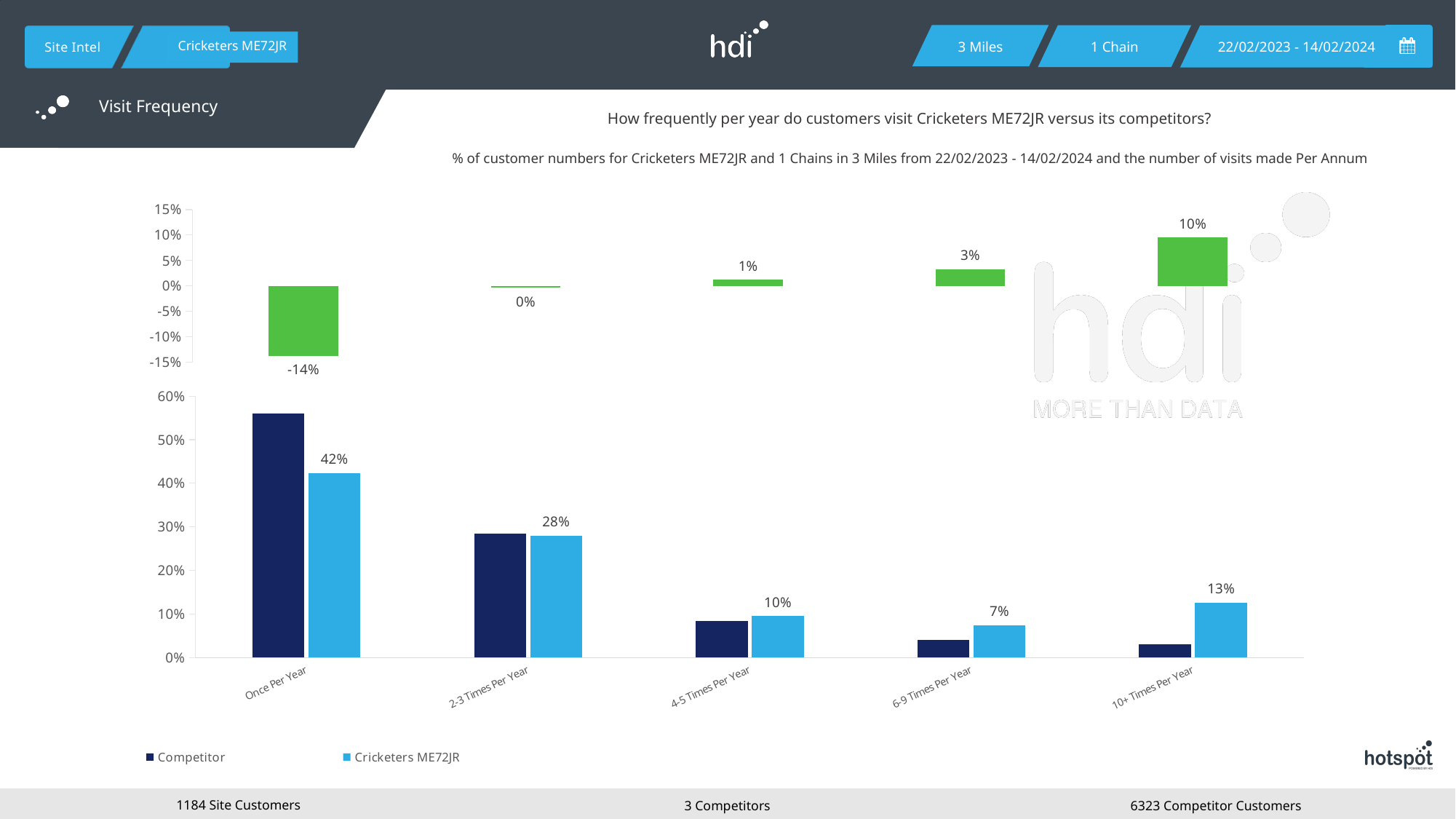
In the top chart, which category has the lowest value? Once Per Year In the bottom chart, what is the difference between the Cricketers ME72JR values for Once Per Year and 2-3 Times Per Year? 14% In the bottom chart, what is the Cricketers ME72JR value for 10+ Times Per Year? 13% In the top chart, what is the value shown for 10+ Times Per Year? 10% How many series does the legend of the bottom chart list? 2 In the bottom chart, what percentage of Cricketers ME72JR customers visit once per year? 42% In the top chart, what is the value shown for Once Per Year? -14% In the bottom chart, what is the Cricketers ME72JR value for 2-3 Times Per Year? 28% How many visit frequency categories are shown on the x axis of the bottom chart? 5 In the bottom chart, which visit frequency category has the highest Cricketers ME72JR value? Once Per Year In the bottom chart, which is larger for Once Per Year: the Competitor bar or the Cricketers ME72JR bar? Competitor In the bottom chart, is the Competitor value for Once Per Year greater or less than 50%? greater